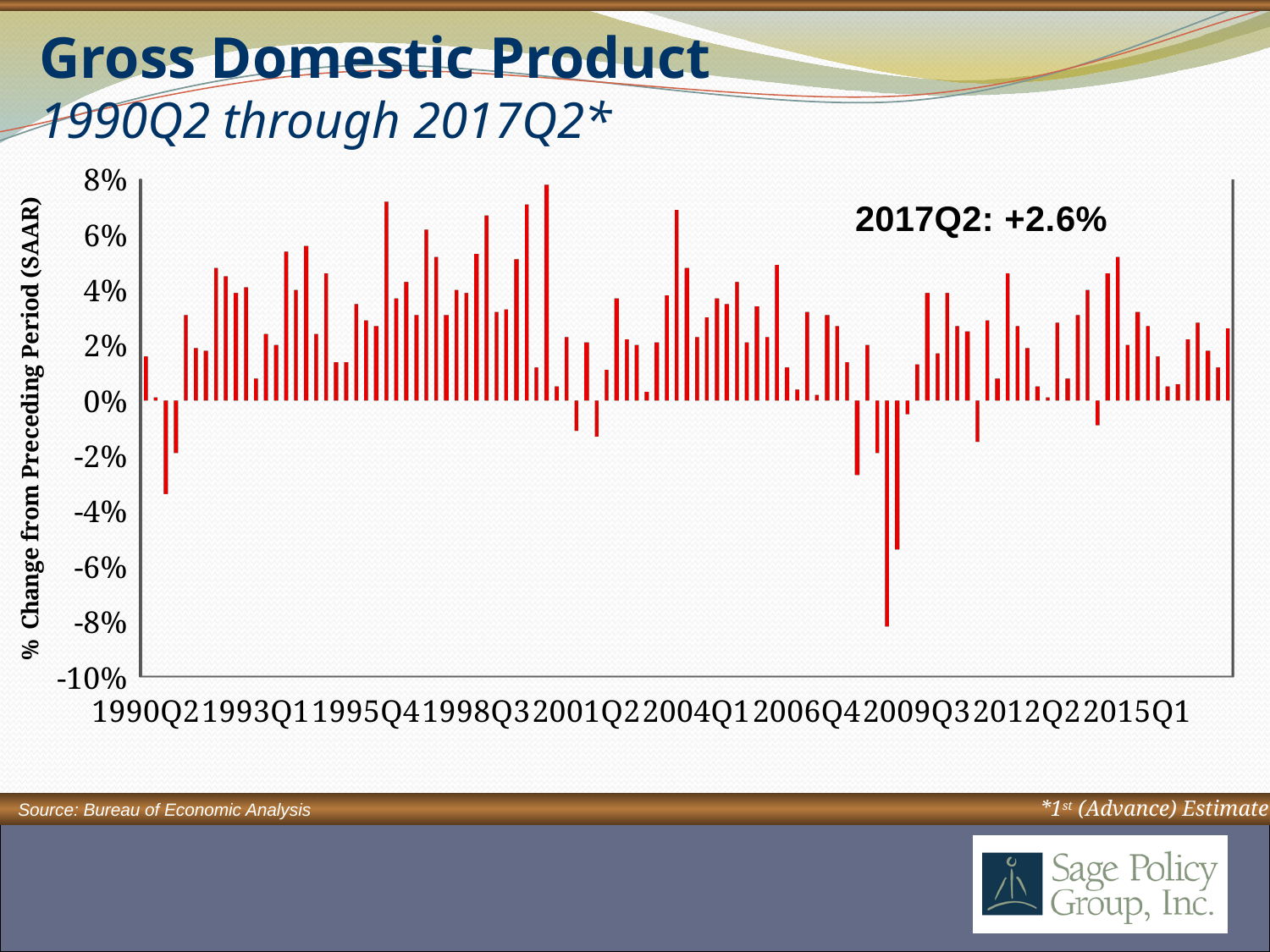
Is the lowest bar on the chart greater or less than -6%? less Is the highest bar on the chart greater or less than 6%? greater What kind of chart is shown on the slide? Bar chart What is the GDP value shown for 2017Q2? +2.6% How many period labels are shown along the x axis? 10 Is the value for 2017Q2 greater or less than 2%? greater What is the label on the vertical axis of the chart? % Change from Preceding Period (SAAR) What period range does the chart subtitle say the data covers? 1990Q2 through 2017Q2*